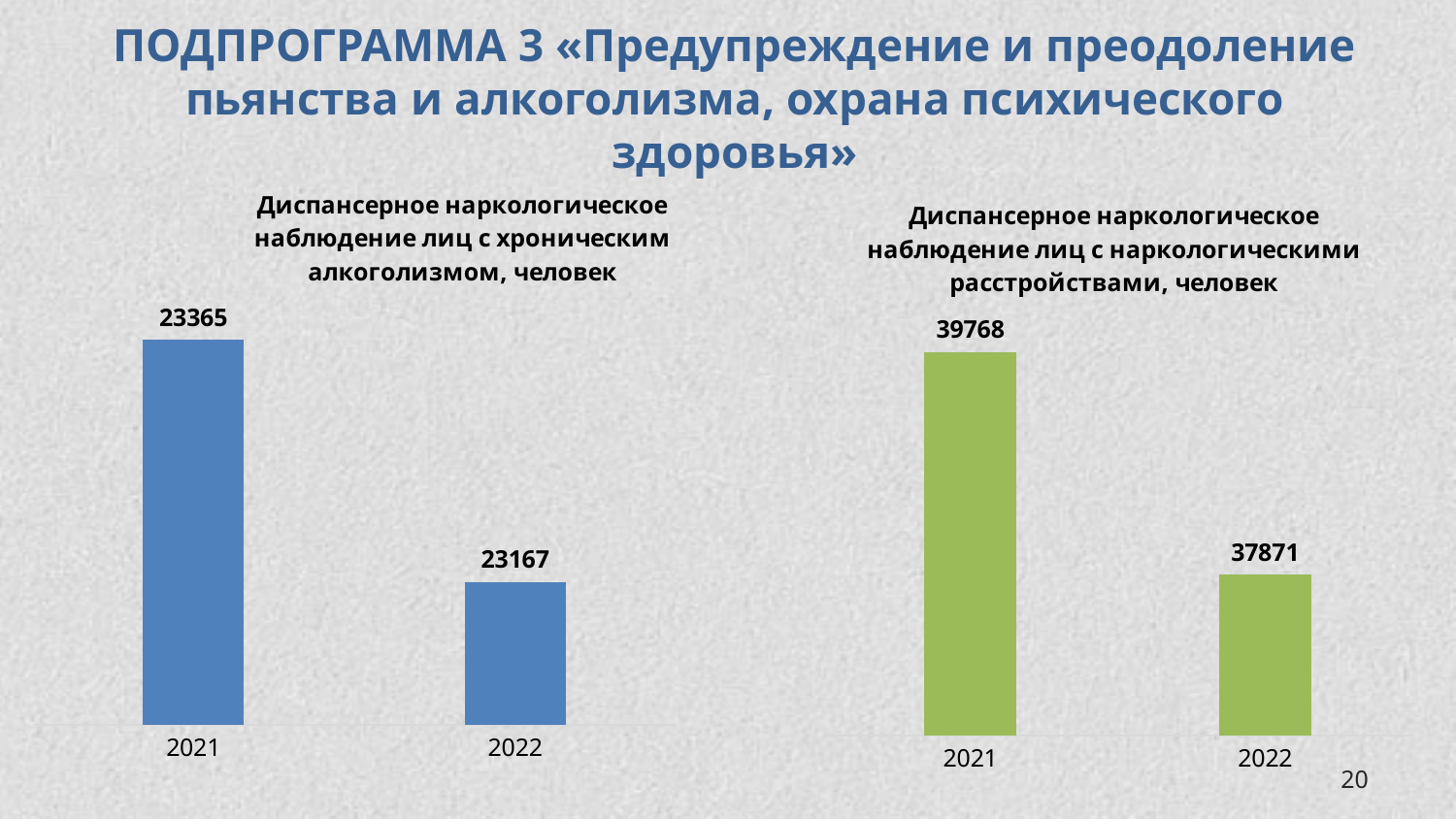
In the left chart (chronic alcoholism), what is the value for 2021? 23365 In the right chart (narcological disorders), by how much did the value decrease from 2021 to 2022? 1897 In the right chart (narcological disorders), what is the value for 2021? 39768 In the right chart (narcological disorders), which year has the lowest value? 2022 In the left chart (chronic alcoholism), which year has the higher value? 2021 What type of chart is the right chart (narcological disorders)? bar chart In the left chart (chronic alcoholism), what is the value for 2022? 23167 In the right chart (narcological disorders), is the value for 2021 larger or smaller than the value for 2022? larger In the left chart (chronic alcoholism), do the values rise or fall from 2021 to 2022? fall How many bars does the left chart (chronic alcoholism) have? 2 In the left chart (chronic alcoholism), what is the difference between the 2021 and 2022 values? 198 In the right chart (narcological disorders), what is the value for 2022? 37871